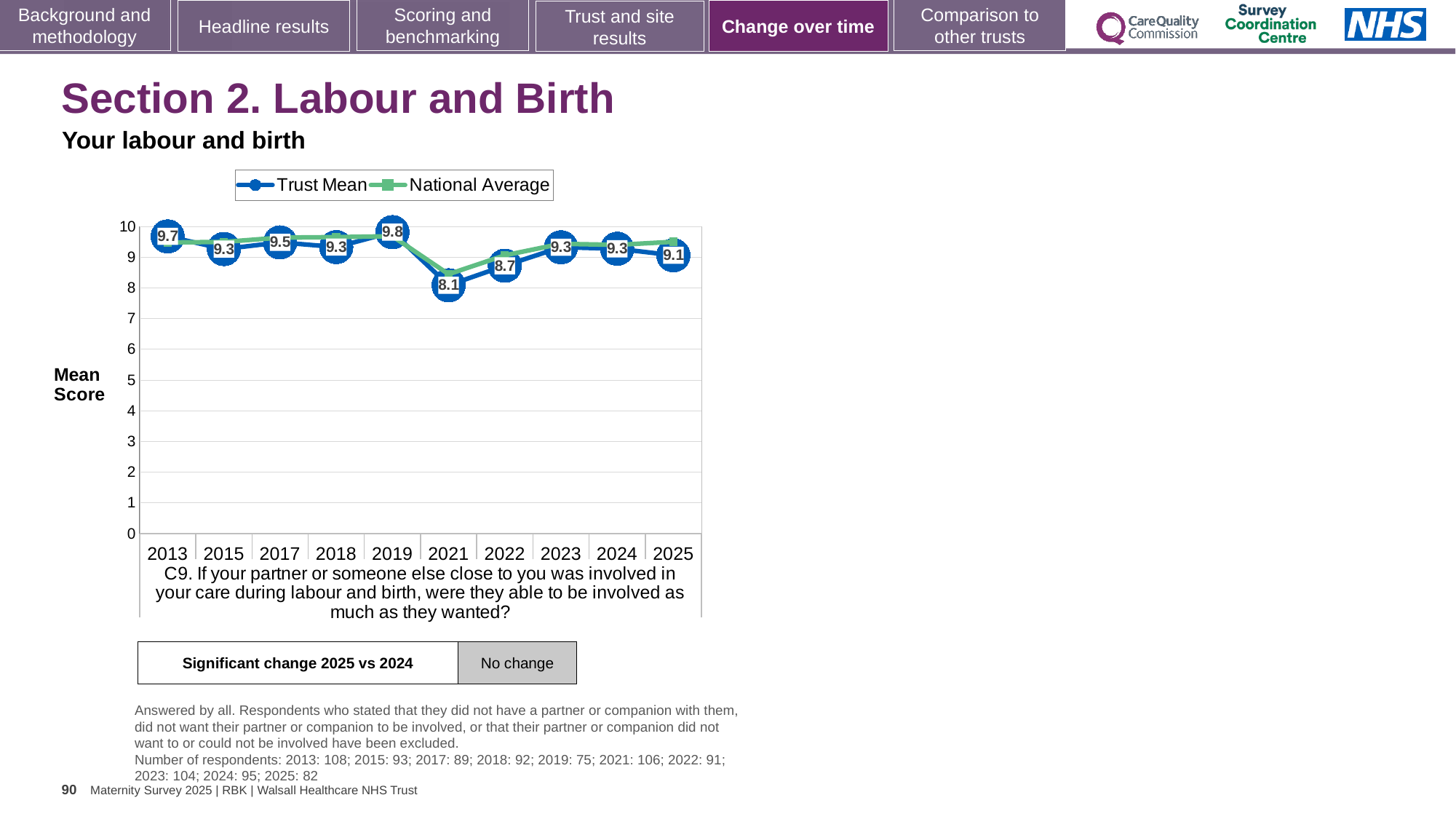
Which year has the larger Trust Mean, 2013 or 2025? 2013 How many years are shown on the x axis? 10 What is the Trust Mean score for 2019? 9.8 Does the Trust Mean rise or fall from 2019 to 2021? Fall What is the difference between the Trust Mean in 2019 and in 2021? 1.7 What is the Trust Mean score for 2021? 8.1 Is the National Average for 2021 greater or less than 9? less In which year is the Trust Mean lowest? 2021 In which year is the Trust Mean highest? 2019 What kind of chart is shown on the slide? Line chart How many series does the legend list? 2 What is the Trust Mean score for 2025? 9.1